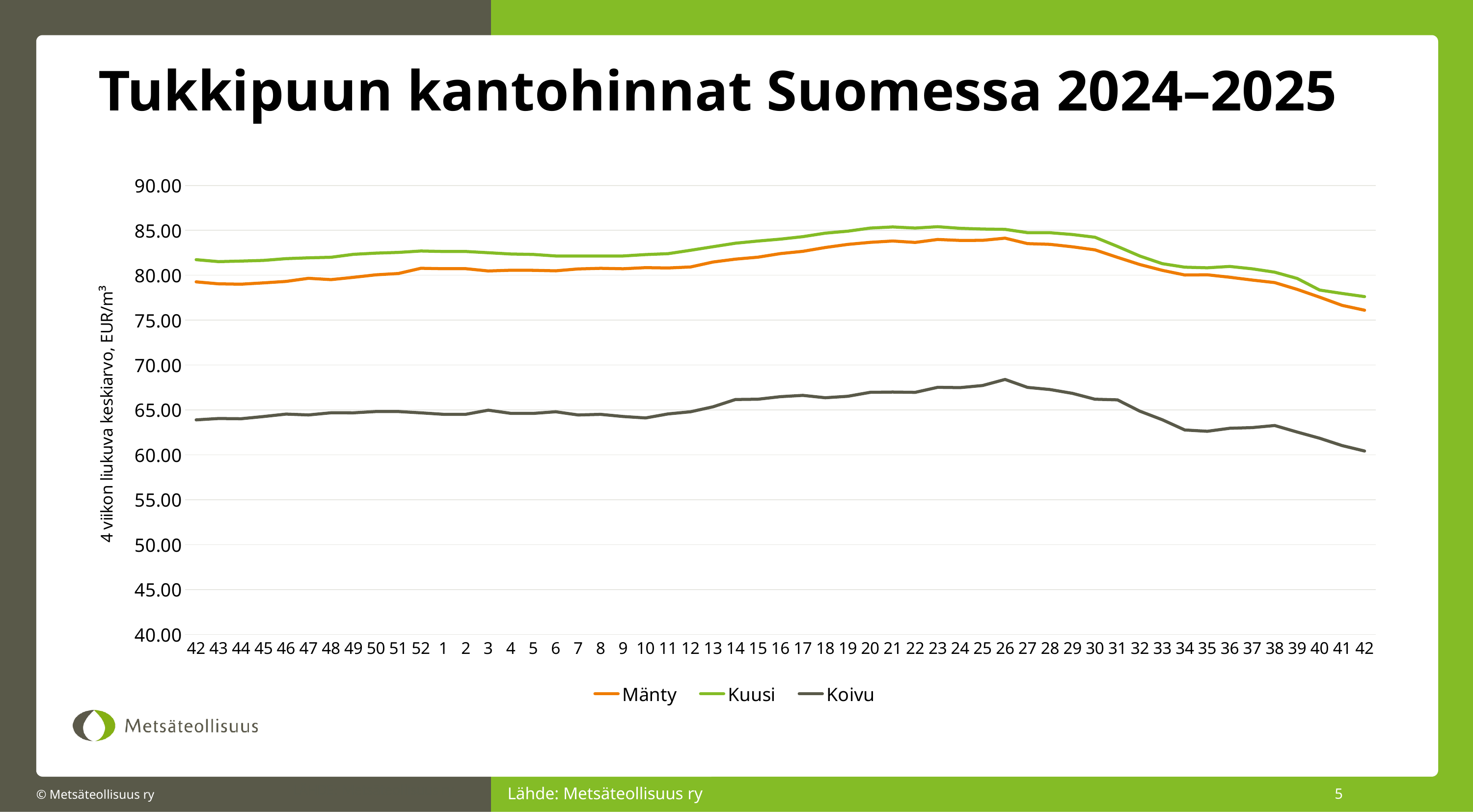
What kind of chart is shown on the slide? line chart Is the value for Koivu at the last week 42 greater or less than 65.00? less Which is larger at week 20, the value for Kuusi or the value for Mänty? Kuusi At which week does the Koivu line reach its highest point? 26 How many series does the legend list? 3 What is the label of the vertical axis? 4 viikon liukuva keskiarvo, EUR/m³ Does the Koivu line rise or fall from week 26 to the final week 42? fall Is the value for Kuusi at the last week 42 greater or less than 80.00? less Which series has the lowest values across the whole chart? Koivu What is the title of the chart? Tukkipuun kantohinnat Suomessa 2024–2025 Which series has the highest values across the whole chart? Kuusi Is the value for Koivu at week 26 greater or less than 65.00? greater